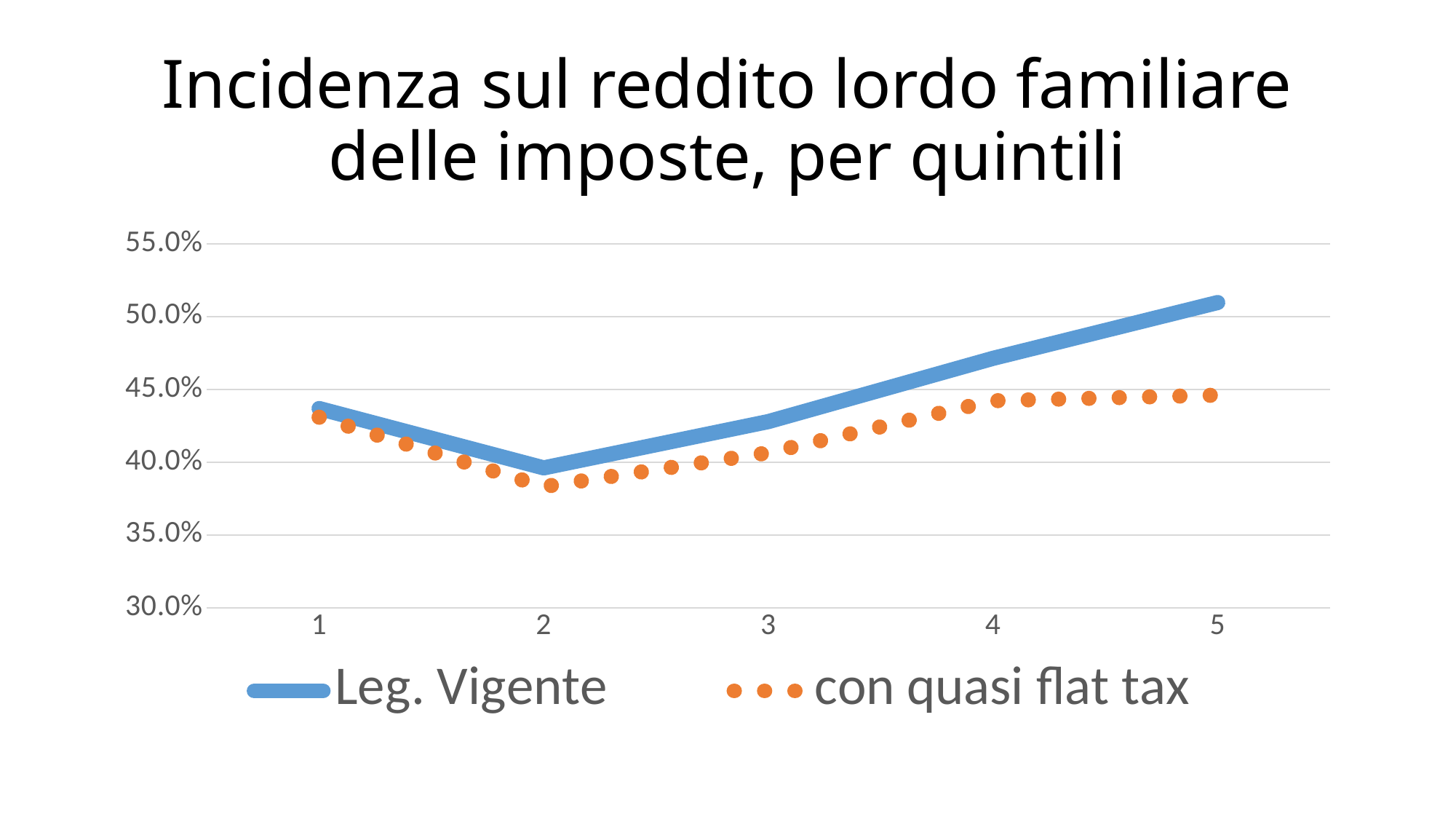
At quintile 5, which series has the higher value, Leg. Vigente or con quasi flat tax? Leg. Vigente Is the value for Leg. Vigente at quintile 4 greater or less than 45.0%? greater Does the Leg. Vigente series rise or fall from quintile 2 to quintile 5? rise At which quintile is the Leg. Vigente series highest? 5 What kind of chart is shown on the slide? line chart At which quintile is the con quasi flat tax series lowest? 2 Is the value for con quasi flat tax at quintile 2 greater or less than 40.0%? less At which quintile is the Leg. Vigente series lowest? 2 What is the title of the chart? Incidenza sul reddito lordo familiare delle imposte, per quintili How many quintiles are plotted along the x axis? 5 Is the value for Leg. Vigente at quintile 3 greater or less than 40.0%? greater How many series does the legend list? 2